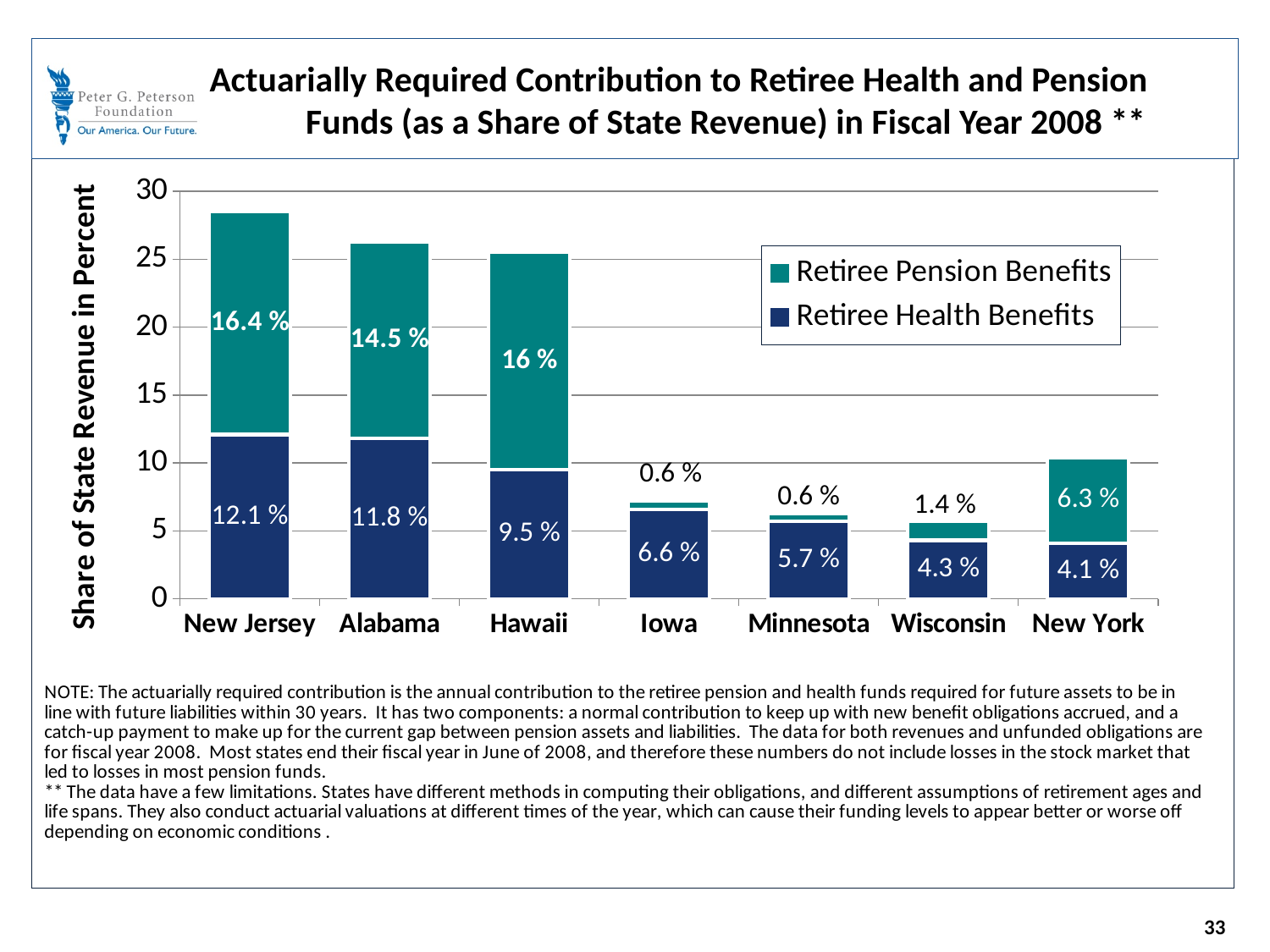
Is the total height of the New Jersey bar greater or less than 25? greater What kind of chart is shown on the slide? Stacked bar chart How many states are shown on the x axis? 7 What is the Retiree Pension Benefits value for New York? 6.3 % What is the Retiree Health Benefits value for New Jersey? 12.1 % Which is larger, the Retiree Pension Benefits value for Hawaii or for Alabama? Hawaii Which state has the lowest Retiree Health Benefits value? New York How many series does the legend list? 2 Which state has the highest Retiree Pension Benefits value? New Jersey What is the difference between the Retiree Health Benefits values for New Jersey and Alabama? 0.3 % What is the Retiree Pension Benefits value for Hawaii? 16 % What is the total of the stacked bar for Iowa? 7.2 %